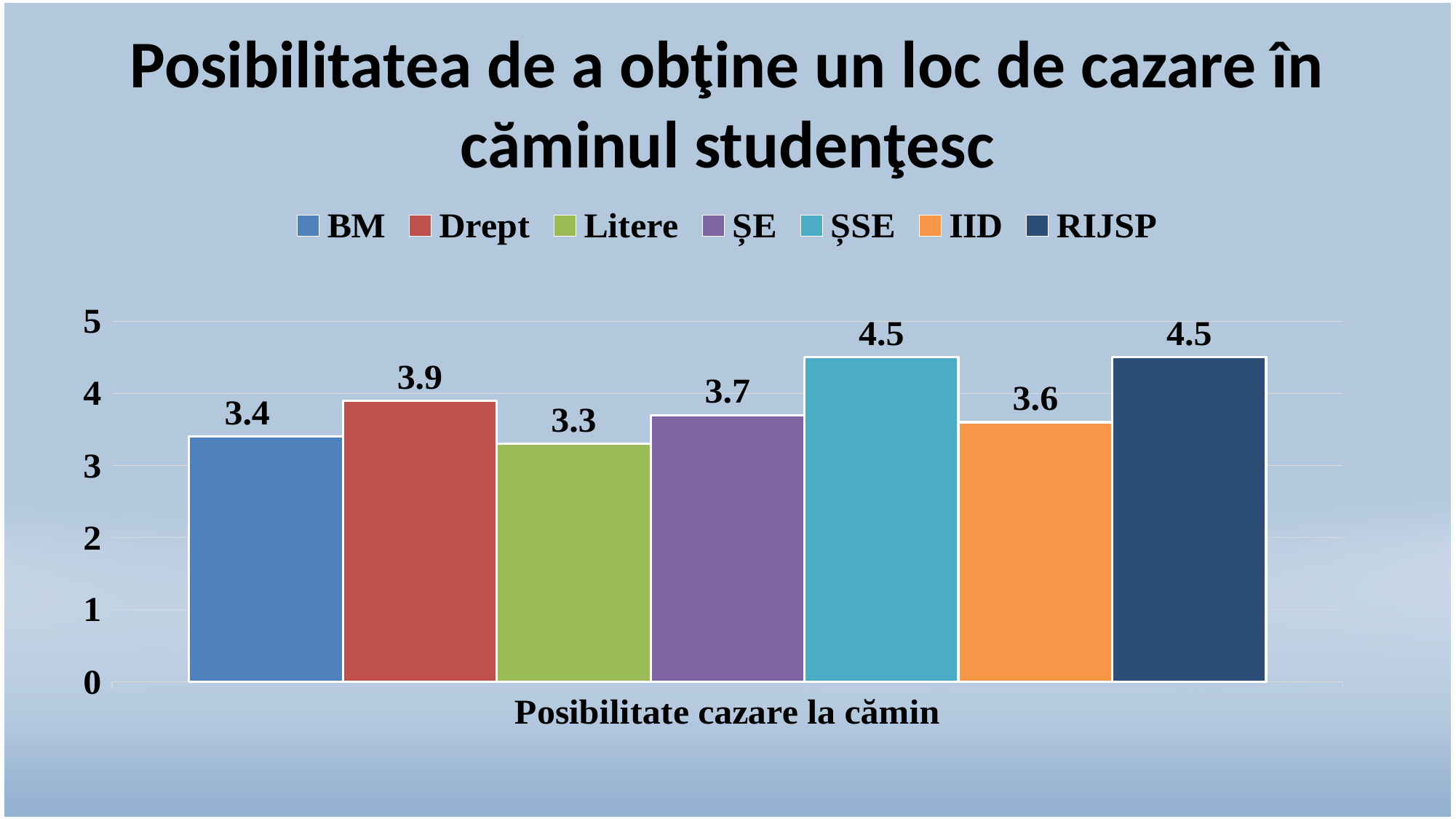
Which series has the lowest value? Litere What is the value for ȘE? 3.7 Which is larger, the value for Drept or the value for IID? Drept How many series does the legend list? 7 What kind of chart is shown on the slide? bar chart Is the value for RIJSP greater or less than 4? greater What is the label shown on the x axis below the bars? Posibilitate cazare la cămin What is the value for Drept? 3.9 What is the difference between the values for ȘSE and Litere? 1.2 What is the difference between the values for Drept and BM? 0.5 What is the value for IID? 3.6 What is the value for BM? 3.4